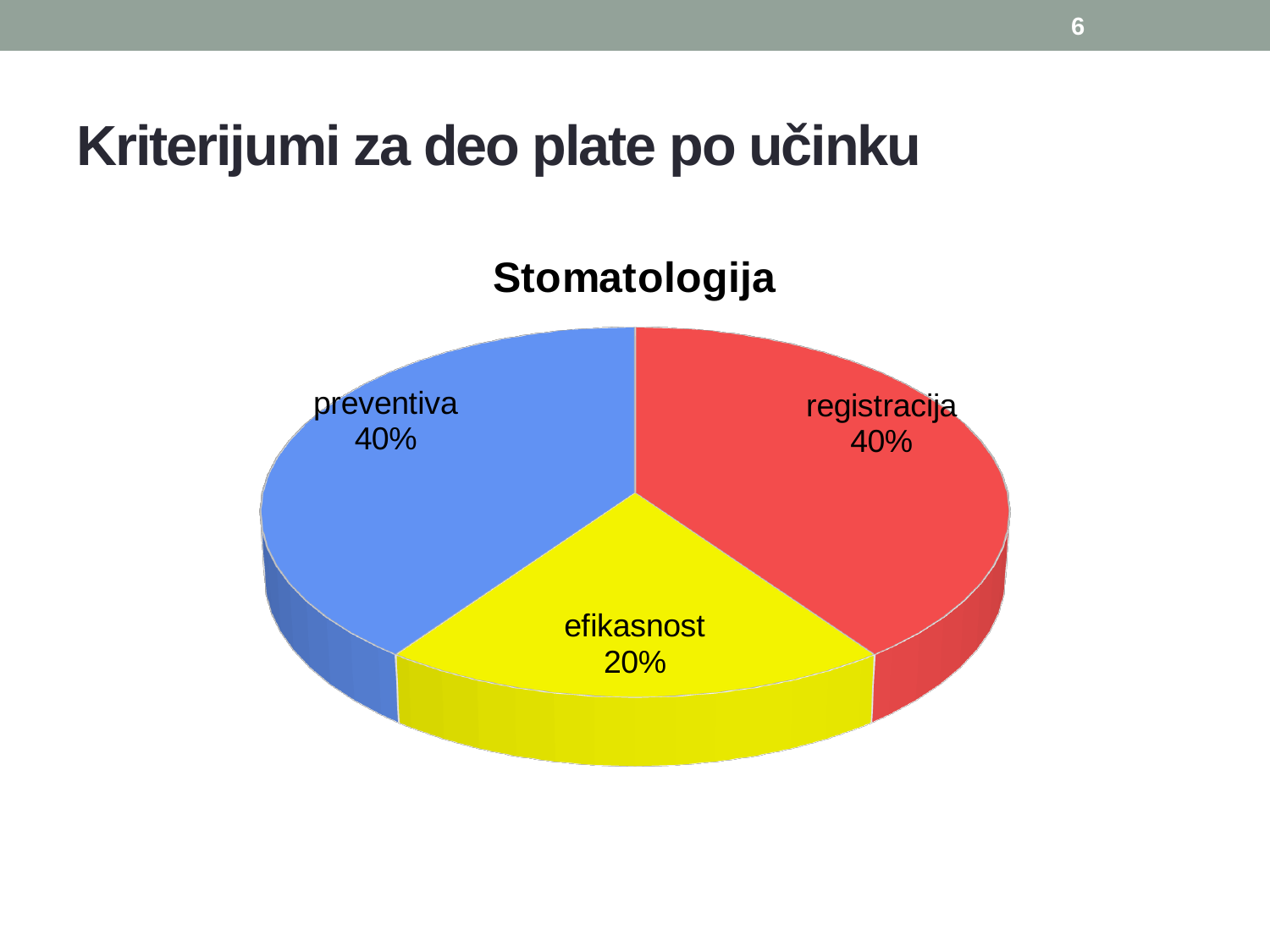
How many slices does the pie chart have? 3 Which is larger, the share for registracija or the share for efikasnost? registracija What is the combined share of preventiva and registracija? 80% What share of the pie does preventiva have? 40% What is the difference between the shares of preventiva and efikasnost? 20% What kind of chart is shown on the slide? pie chart What share of the pie does registracija have? 40% What colour is the efikasnost slice? yellow What share of the pie does efikasnost have? 20% What is the title of the chart? Stomatologija Which category has the smallest slice of the pie? efikasnost